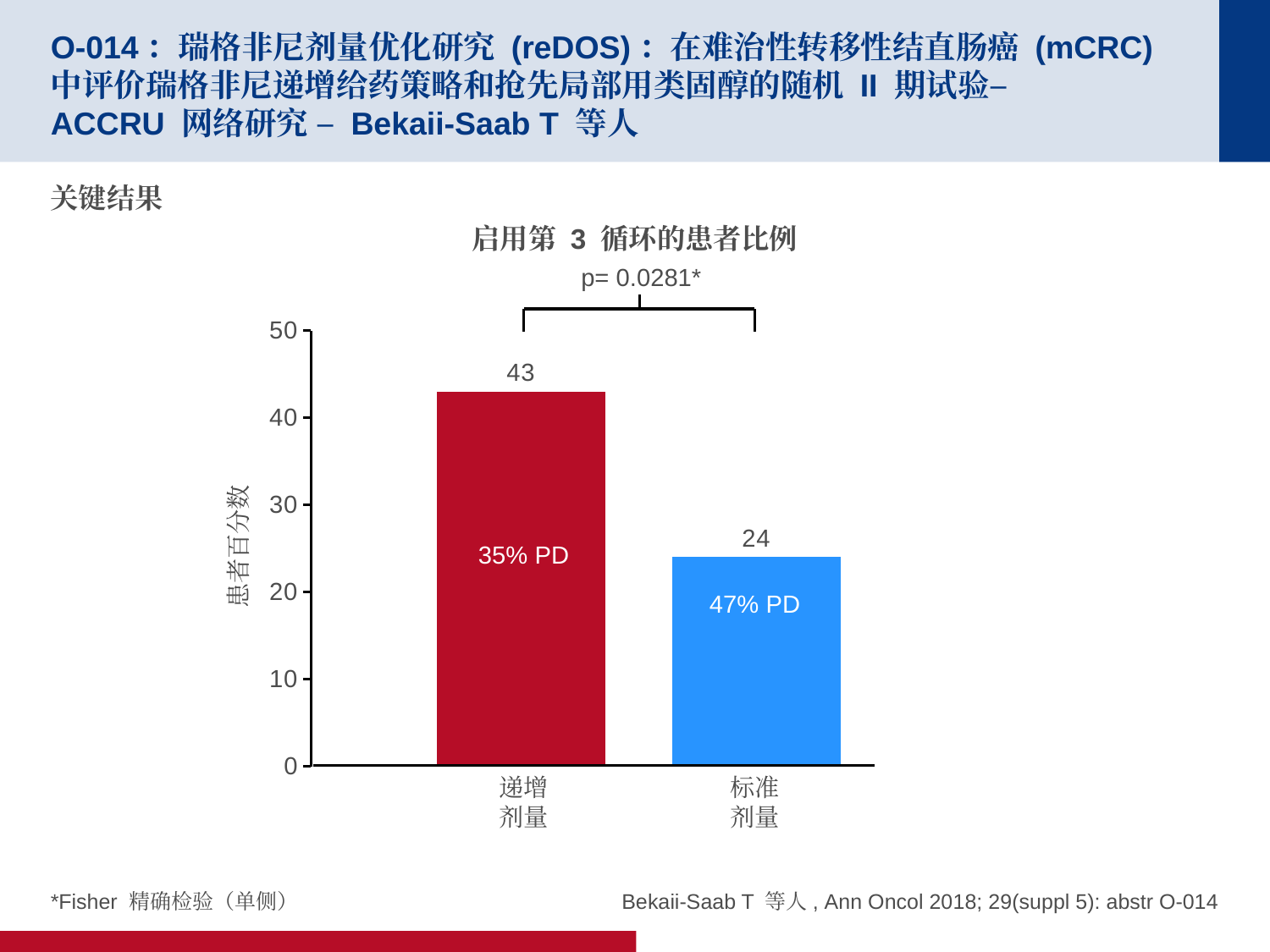
Is the value for 标准剂量 greater or less than 30? less How many categories are shown on the x axis? 2 What p-value is shown above the bars? p= 0.0281* What is the difference between the values for 递增剂量 and 标准剂量? 19 What is the value for 标准剂量 (standard dose)? 24 Which category has the lowest value? 标准剂量 What is the title of the chart? 启用第 3 循环的患者比例 What is the value for 递增剂量 (dose escalation)? 43 Which is larger, the value for 递增剂量 or for 标准剂量? 递增剂量 What kind of chart is shown? bar chart Is the value for 递增剂量 greater or less than 40? greater Which category has the highest value? 递增剂量